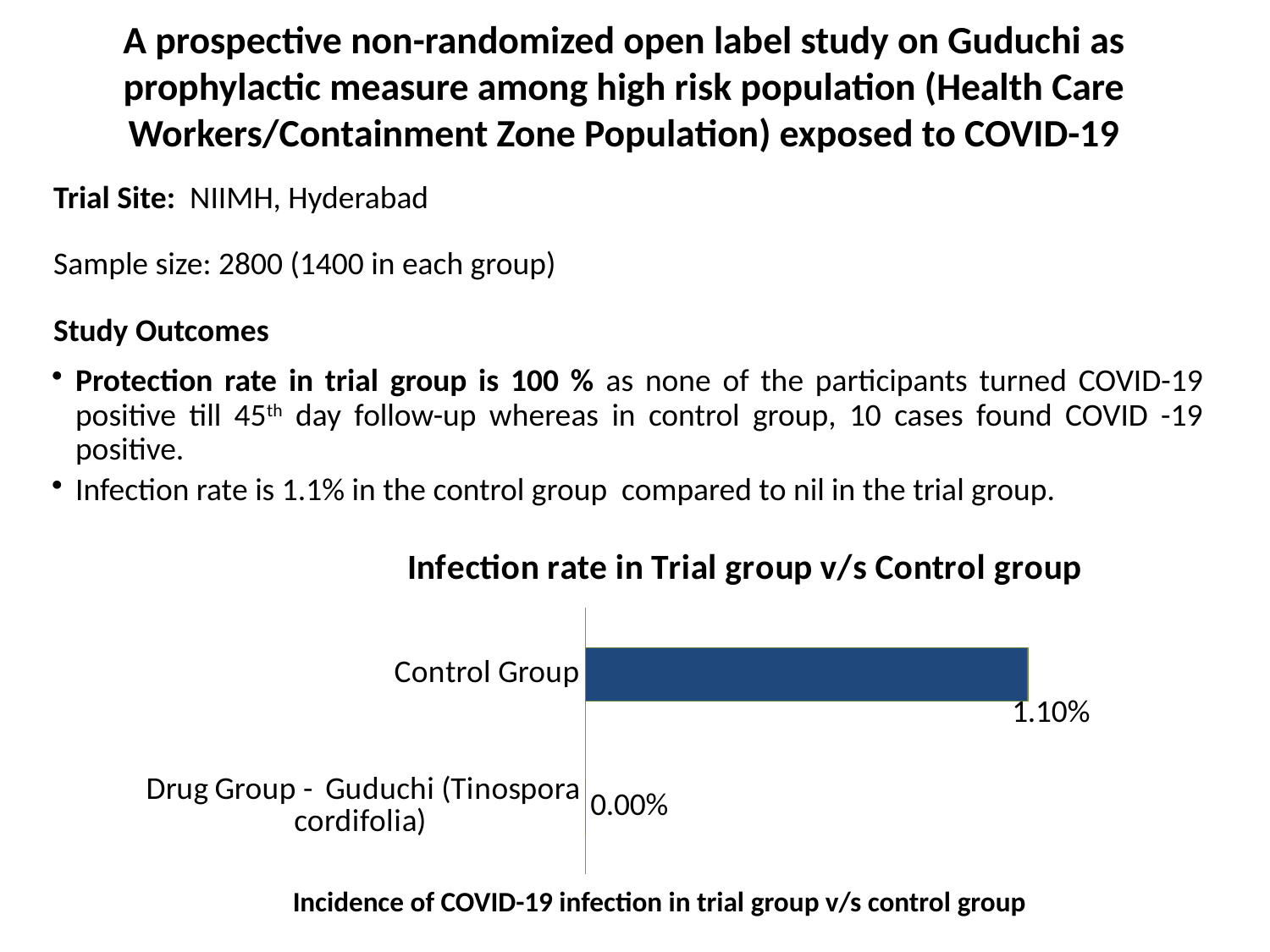
Is the infection rate for the Control Group larger or smaller than that of the Drug Group? larger What is the infection rate shown for the Control Group? 1.10% What caption appears below the chart? Incidence of COVID-19 infection in trial group v/s control group How many groups are plotted in the chart? 2 What is the difference in infection rate between the Control Group and the Drug Group? 1.10% Which group has the higher infection rate in the chart? Control Group What is the title of the chart? Infection rate in Trial group v/s Control group What type of chart is used to show the infection rates? bar chart Which group has the lower infection rate in the chart? Drug Group - Guduchi (Tinospora cordifolia) What is the infection rate shown for the Drug Group - Guduchi (Tinospora cordifolia)? 0.00%